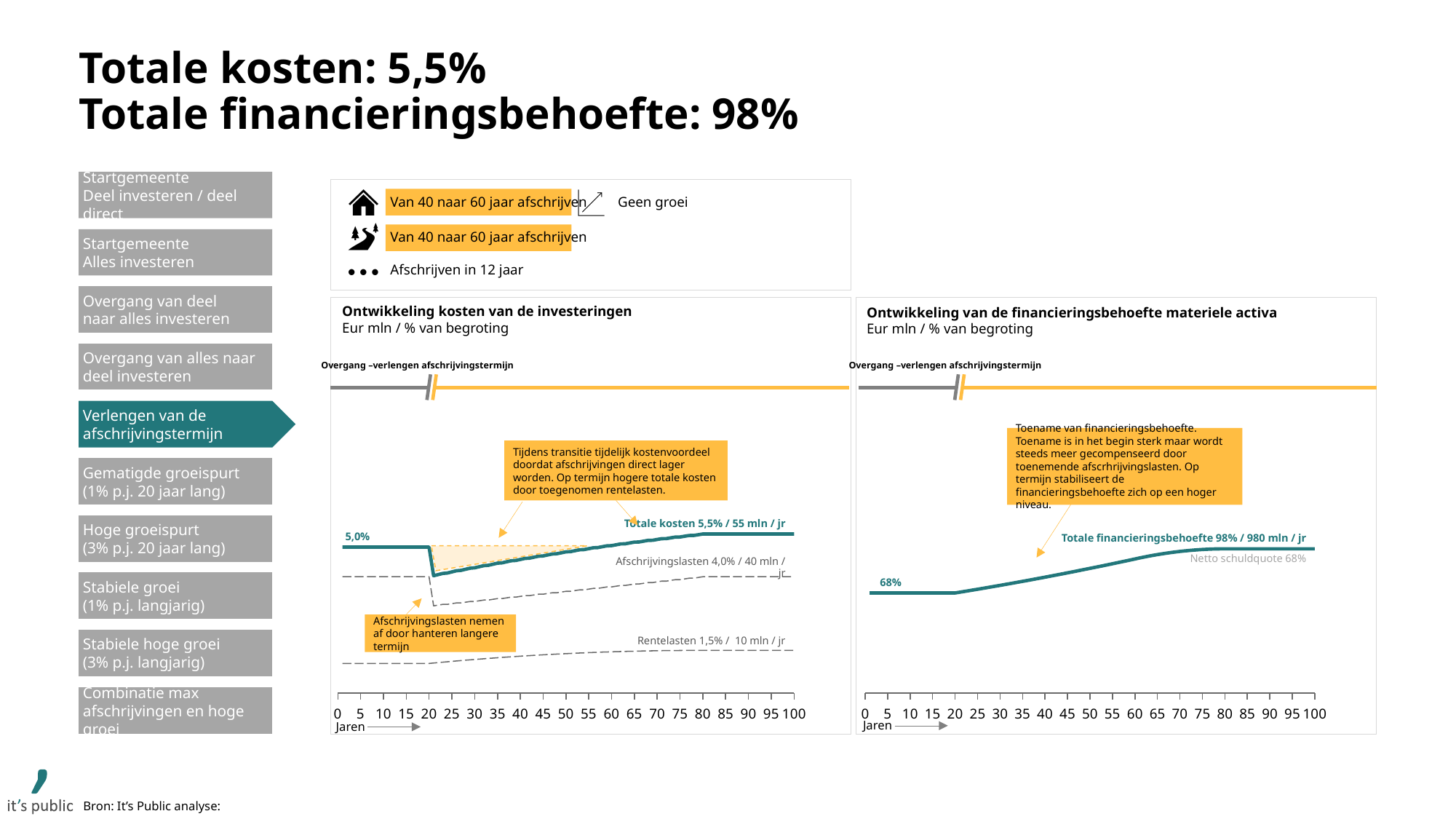
In the chart 'Ontwikkeling kosten van de investeringen', what is the starting value of the total cost line at year 0? 5,0% In the chart 'Ontwikkeling kosten van de investeringen', what is the final value labelled for Afschrijvingslasten? 4,0% / 40 mln / jr In the chart 'Ontwikkeling van de financieringsbehoefte materiele activa', what is the difference between the final value (98%) and the starting value (68%)? 30 percentage points In the chart 'Ontwikkeling van de financieringsbehoefte materiele activa', what is the starting value of the line at year 0? 68% In the chart 'Ontwikkeling van de financieringsbehoefte materiele activa', does the line rise or fall over the years? rise In the chart 'Ontwikkeling van de financieringsbehoefte materiele activa', what is the final value labelled for Totale financieringsbehoefte? 98% / 980 mln / jr In the chart 'Ontwikkeling kosten van de investeringen', which ends higher: Afschrijvingslasten or Rentelasten? Afschrijvingslasten In the chart 'Ontwikkeling kosten van de investeringen', what is the final value of the total cost line (Totale kosten)? 5,5% / 55 mln / jr In the chart 'Ontwikkeling kosten van de investeringen', by how many percentage points does the total cost line end higher than it starts (5,0% to 5,5%)? 0,5 percentage points What type of chart is 'Ontwikkeling kosten van de investeringen'? line chart In the chart 'Ontwikkeling kosten van de investeringen', what is the final value labelled for Rentelasten? 1,5% / 10 mln / jr What is the last value shown on the x axis (Jaren) of the chart 'Ontwikkeling kosten van de investeringen'? 100